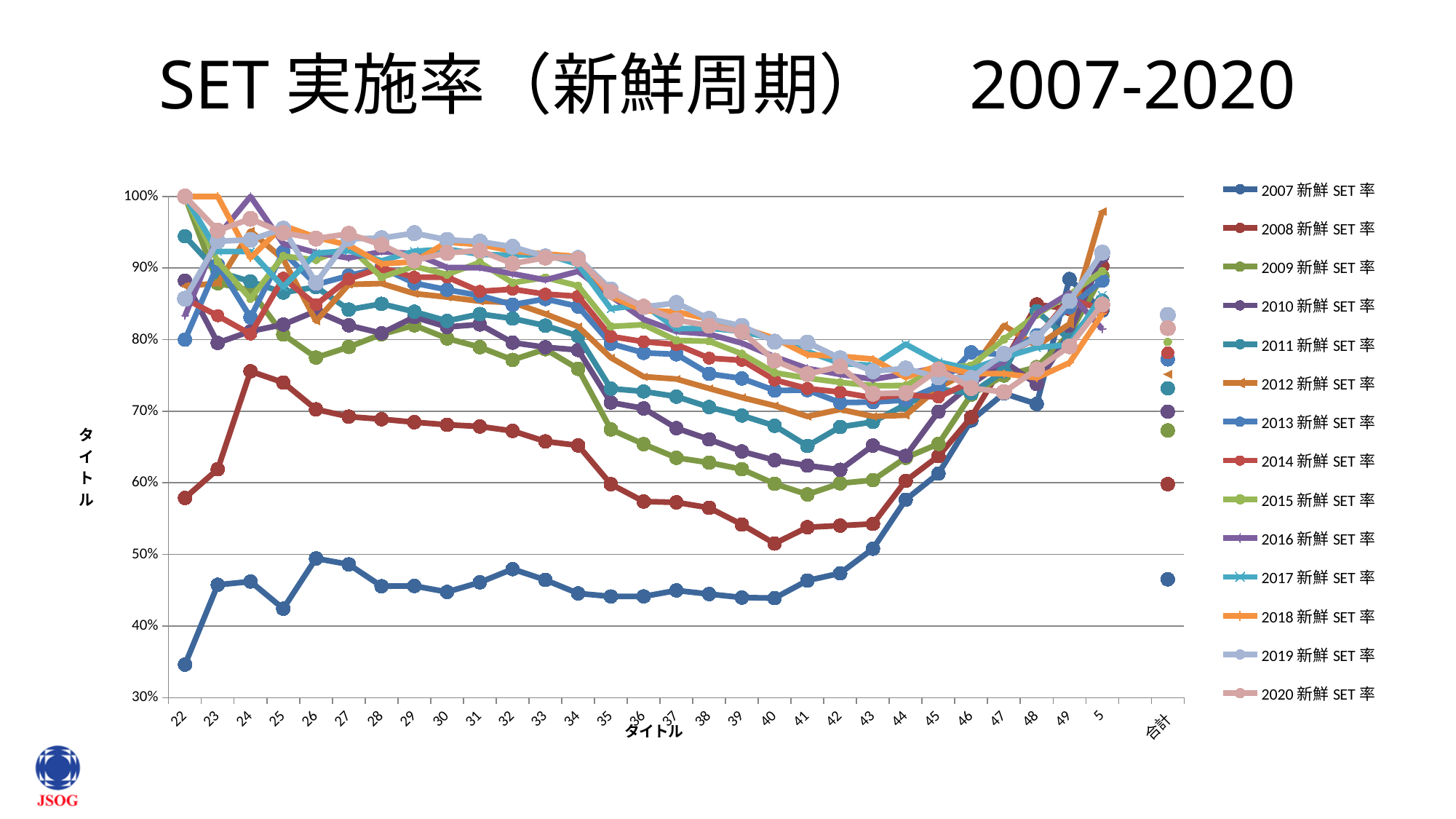
Which series has the lowest value at category 40? 2007 新鮮 SET 率 How many series does the legend list? 14 Is the value for the 2007 新鮮 SET 率 series at 合計 greater or less than 50%? less Is the value for the 2007 新鮮 SET 率 series at category 49 greater or less than 80%? greater Is the value for the 2008 新鮮 SET 率 series at category 24 greater or less than 70%? greater What kind of chart is shown on the slide? line chart What is the title of the slide's chart? SET 実施率（新鮮周期） 2007-2020 What is the legend entry for the first (dark blue) series? 2007 新鮮 SET 率 At category 22, which is larger: the 2007 新鮮 SET 率 value or the 2008 新鮮 SET 率 value? 2008 新鮮 SET 率 Does the 2007 新鮮 SET 率 series rise or fall from category 22 to category 23? rise